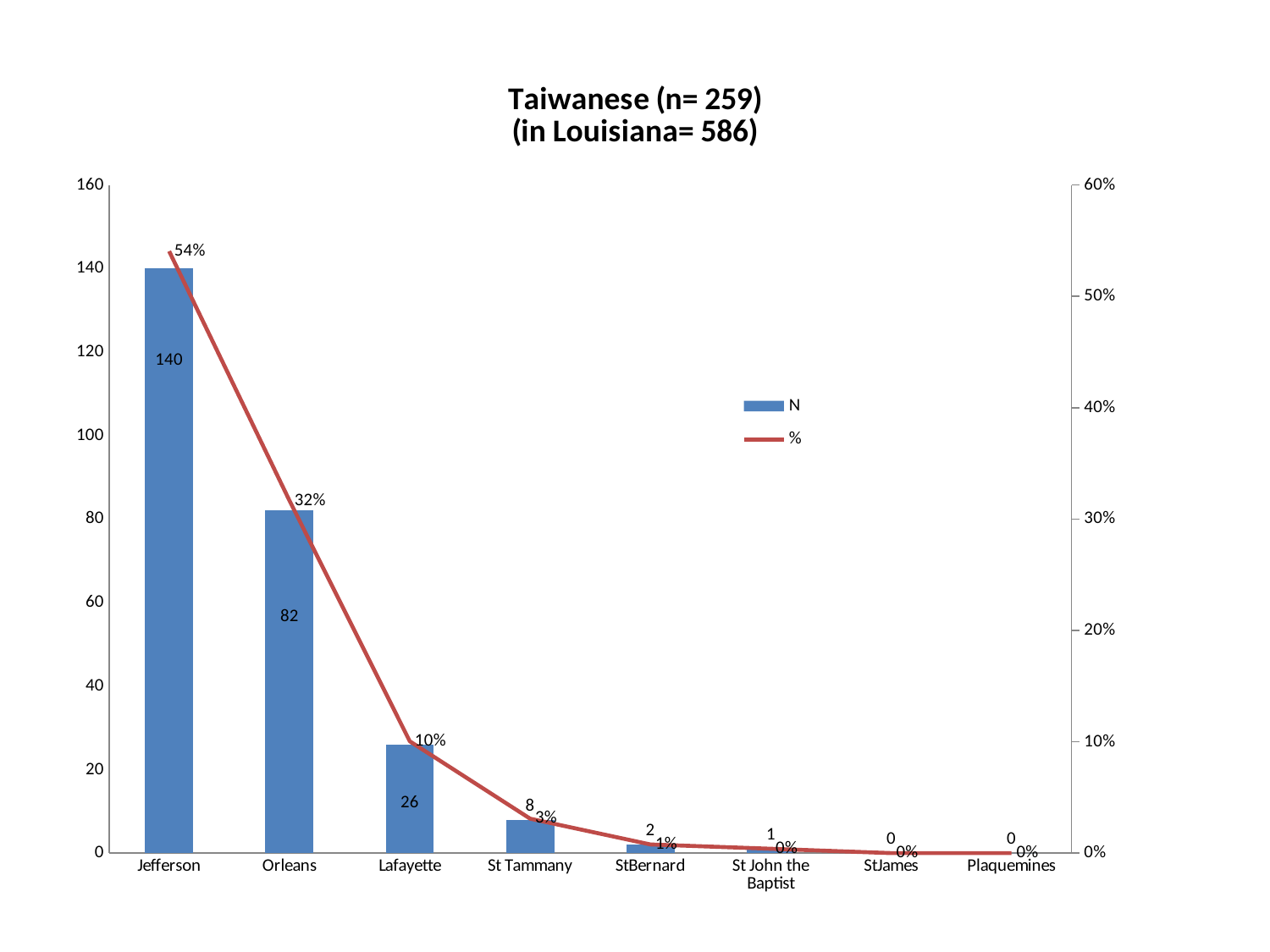
What is the difference in N between Jefferson and Orleans? 58 What is the title of the chart? Taiwanese (n= 259) (in Louisiana= 586) What is the N value for Lafayette? 26 How many series does the legend list? 2 What is the N value for Jefferson? 140 What percentage is shown for Orleans? 32% How many parishes are shown on the x axis? 8 Which parish has the highest N value? Jefferson Do the N values rise or fall from Jefferson to Plaquemines? fall What percentage is shown for St Tammany? 3% Which has a larger N value, Lafayette or St Tammany? Lafayette What kind of chart is used for the N series? bar chart